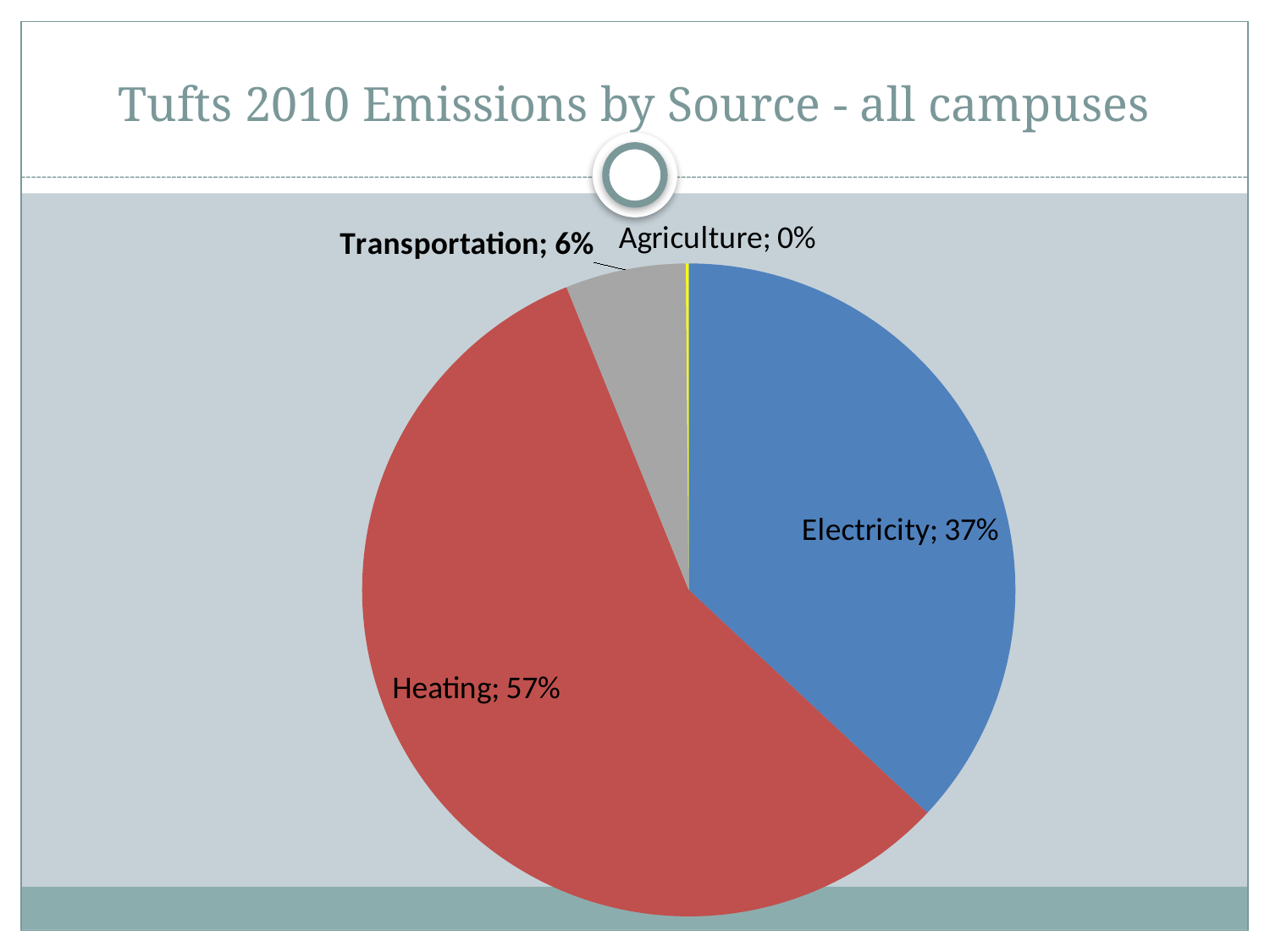
What share of emissions comes from Heating? 57% What share of emissions comes from Electricity? 37% Which is larger, the Electricity share or the Transportation share? Electricity What colour is the Heating slice? red What kind of chart is shown on the slide? pie chart What share of emissions comes from Agriculture? 0% Which source accounts for the largest share of emissions? Heating How many percentage points larger is the Heating share than the Electricity share? 20 How many sources are shown in the pie chart? 4 What share of emissions comes from Transportation? 6% Which source accounts for the smallest share of emissions? Agriculture What is the title of the chart on the slide? Tufts 2010 Emissions by Source - all campuses